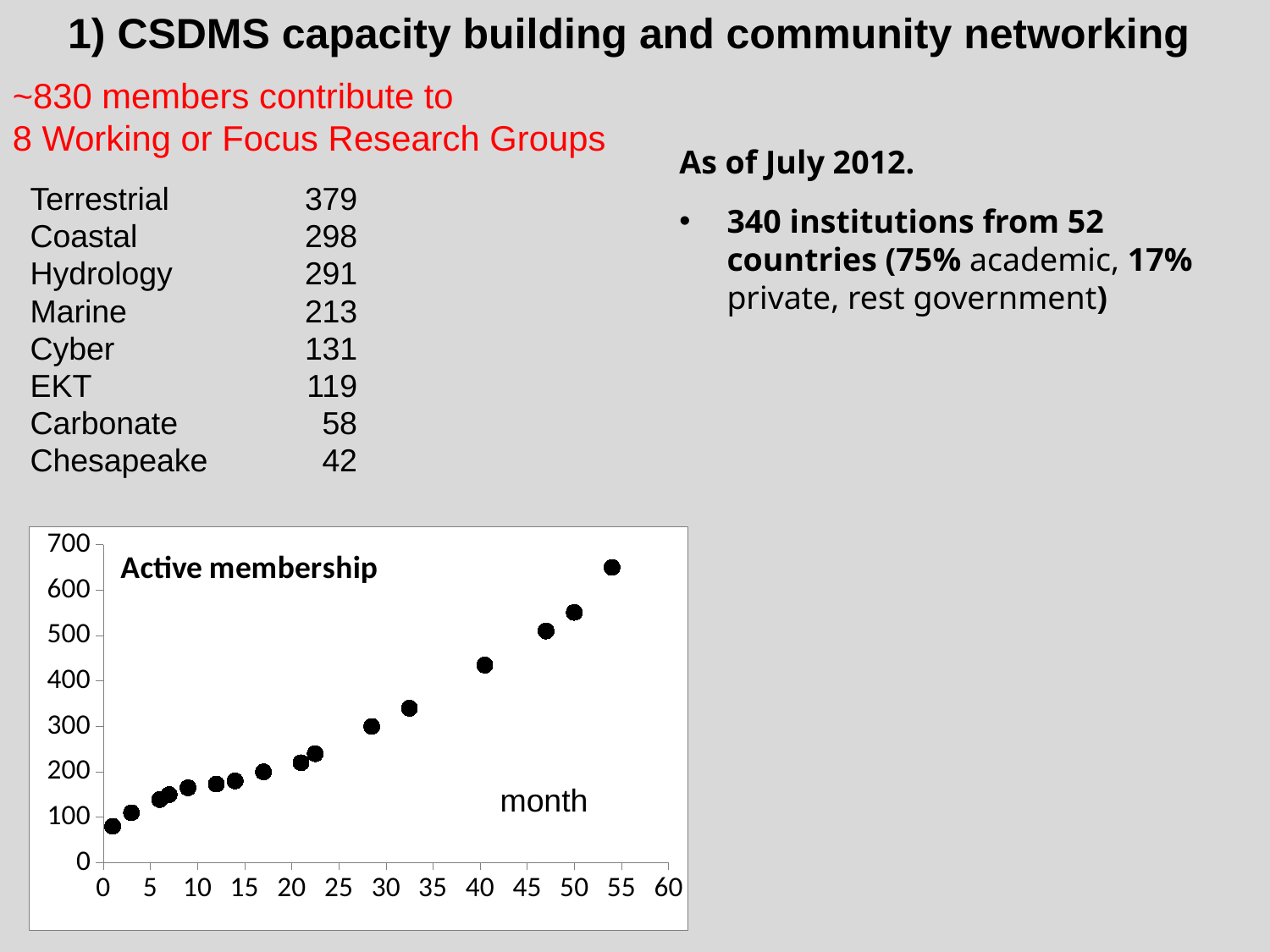
Is the active membership value at around month 40 greater or less than 400? greater Do the active membership values rise or fall as the month increases? rise Is the active membership value at the first plotted point (around month 1) greater or less than 100? less Which is larger, the active membership at around month 54 or at around month 47? month 54 What kind of chart is shown on the slide? scatter chart Is the active membership value at around month 17 greater or less than 300? less What is the title of the chart? Active membership What is the highest value shown on the y axis of the chart? 700 What label is shown for the x axis of the chart? month